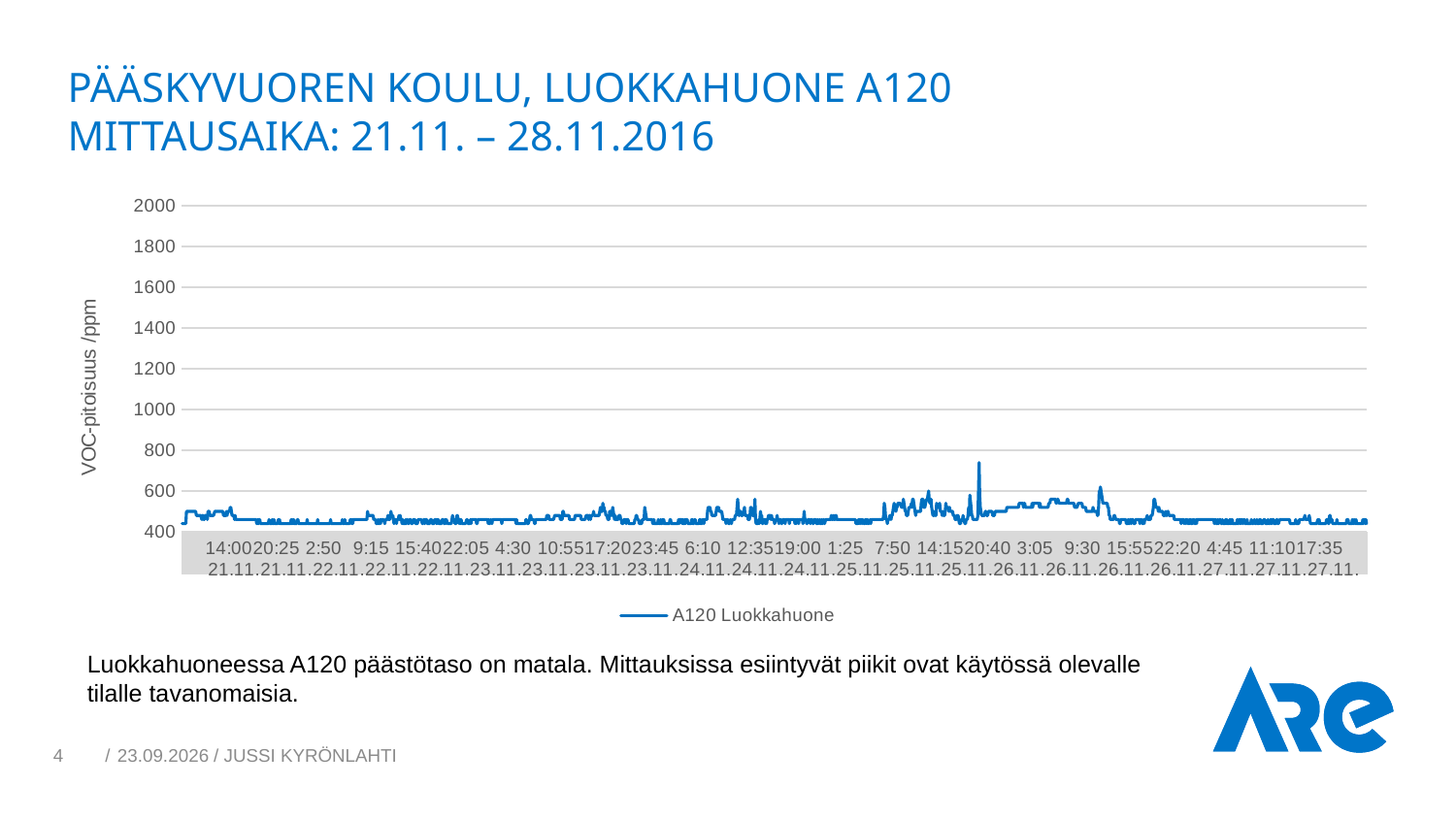
What is the label of the vertical axis of the chart? VOC-pitoisuus /ppm Does the A120 Luokkahuone line ever exceed 1000 ppm during the measurement period? No Is the value of the A120 Luokkahuone line at the start of the measurement (14:00 on 21.11.) greater or less than 1000? less What is the maximum value shown on the vertical axis of the chart? 2000 What kind of chart is shown on the slide? line chart Is the highest peak of the A120 Luokkahuone line greater or less than 600? greater How many series does the chart legend list? 1 What is the name of the series shown in the chart legend? A120 Luokkahuone